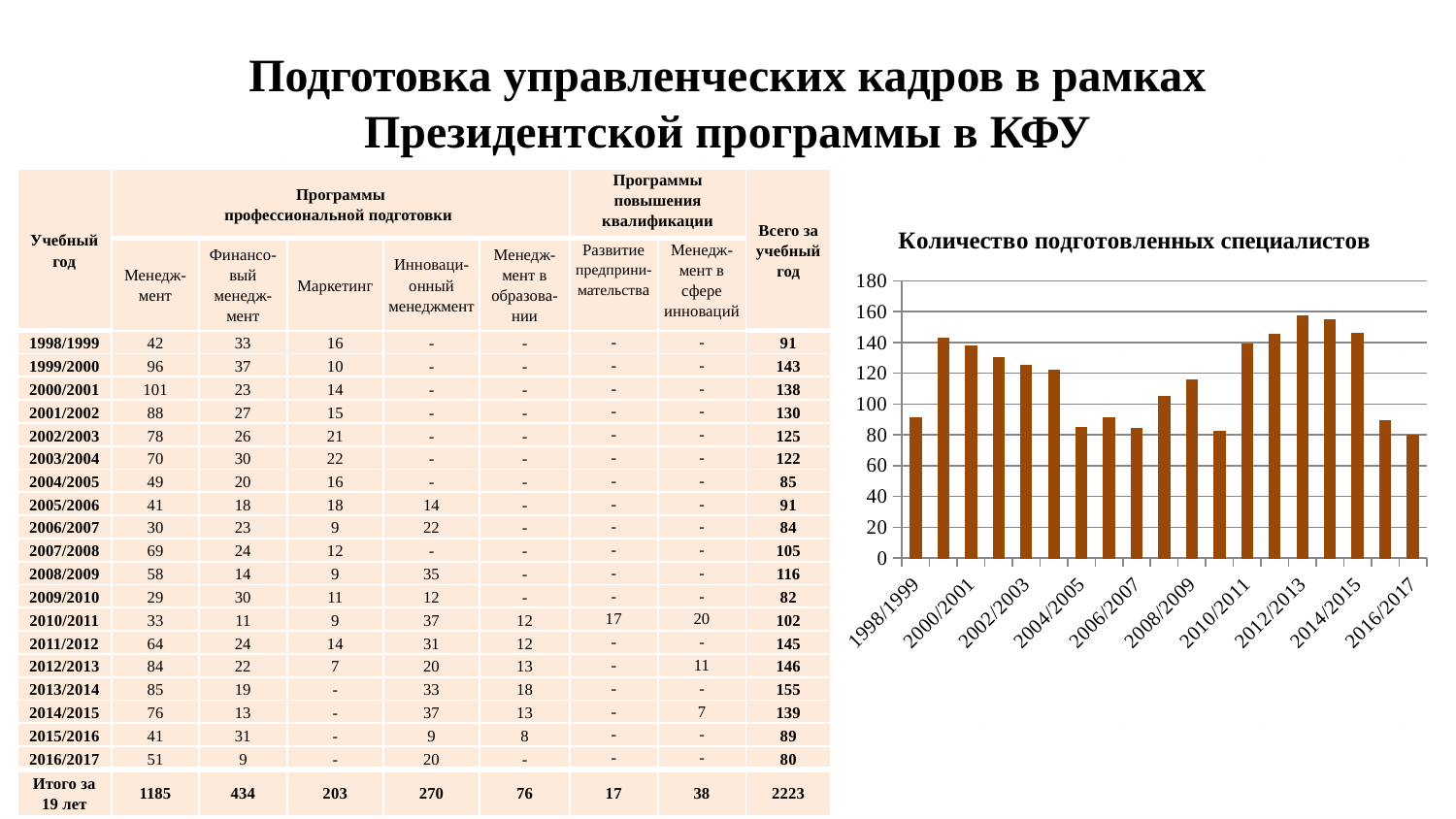
In the chart "Количество подготовленных специалистов", is the value for 1999/2000 greater or less than 120? greater In the chart "Количество подготовленных специалистов", do the values rise or fall from 2009/2010 to 2013/2014? rise How many bars (academic years) are plotted in the chart "Количество подготовленных специалистов"? 19 In the chart "Количество подготовленных специалистов", is the value for 2016/2017 greater or less than 100? less What kind of chart is "Количество подготовленных специалистов"? bar chart In the chart "Количество подготовленных специалистов", which academic year has the highest bar? 2012/2013 In the chart "Количество подготовленных специалистов", which is larger: the value for 2000/2001 or the value for 2006/2007? 2000/2001 What is the title of the bar chart on the slide? Количество подготовленных специалистов In the chart "Количество подготовленных специалистов", is the value for 2004/2005 greater or less than 100? less In the chart "Количество подготовленных специалистов", do the values rise or fall from 1999/2000 to 2004/2005? fall In the chart "Количество подготовленных специалистов", which is larger: the value for 2008/2009 or the value for 2009/2010? 2008/2009